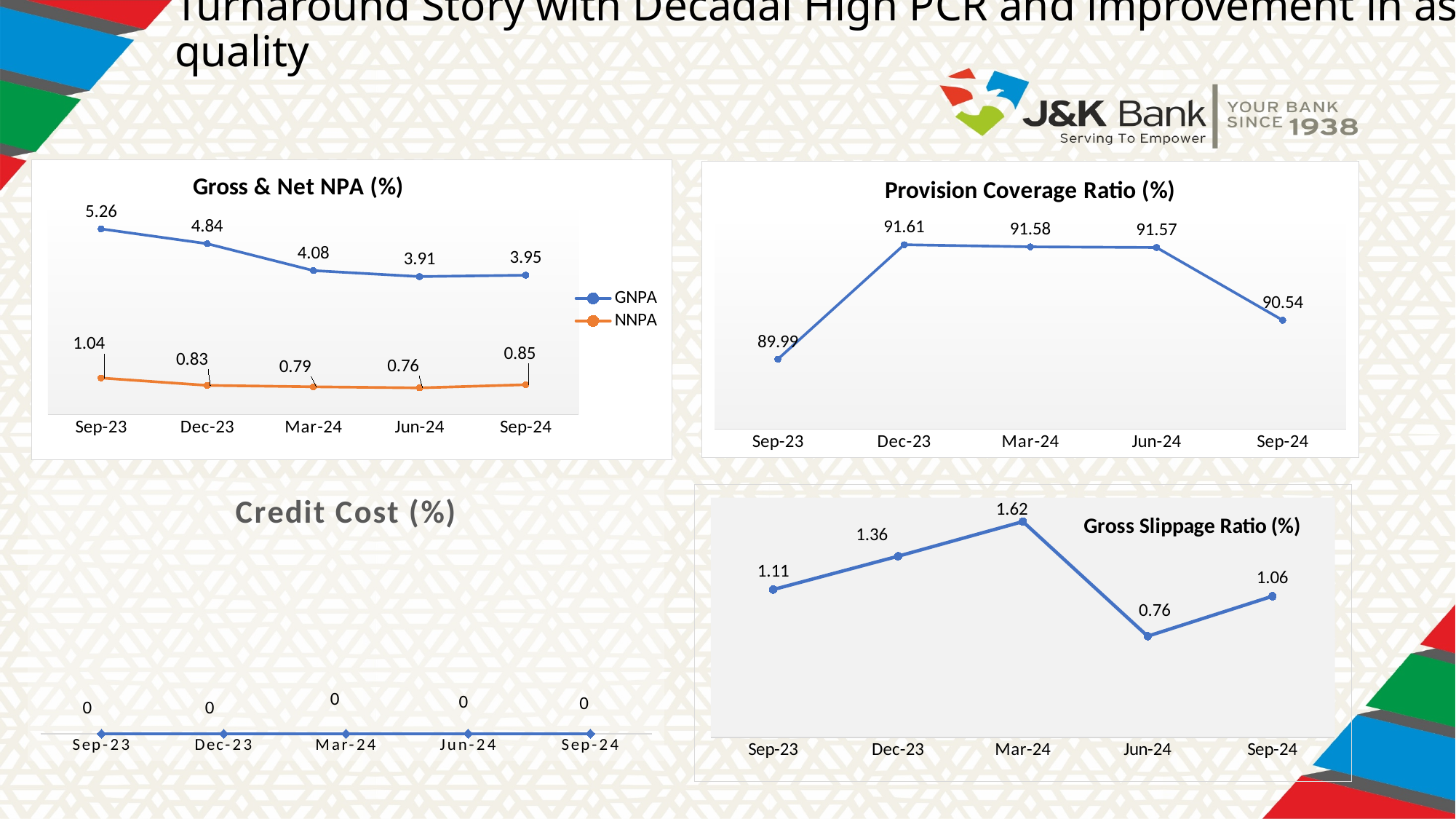
In the 'Gross & Net NPA (%)' chart, how many series does the legend list? 2 In the 'Gross & Net NPA (%)' chart, what is the GNPA value for Sep-23? 5.26 In the 'Gross Slippage Ratio (%)' chart, is the value for Dec-23 larger or smaller than the value for Sep-24? larger In the 'Provision Coverage Ratio (%)' chart, what is the value for Sep-24? 90.54 What type of chart is the 'Provision Coverage Ratio (%)' chart? line chart In the 'Provision Coverage Ratio (%)' chart, which period has the lowest value? Sep-23 In the 'Credit Cost (%)' chart, how many data points are plotted? 5 In the 'Gross & Net NPA (%)' chart, what is the difference between the GNPA values for Sep-23 and Sep-24? 1.31 In the 'Gross & Net NPA (%)' chart, what is the NNPA value for Jun-24? 0.76 In the 'Provision Coverage Ratio (%)' chart, which period has the highest value? Dec-23 In the 'Gross Slippage Ratio (%)' chart, which period has the lowest value? Jun-24 In the 'Gross Slippage Ratio (%)' chart, what is the value for Mar-24? 1.62